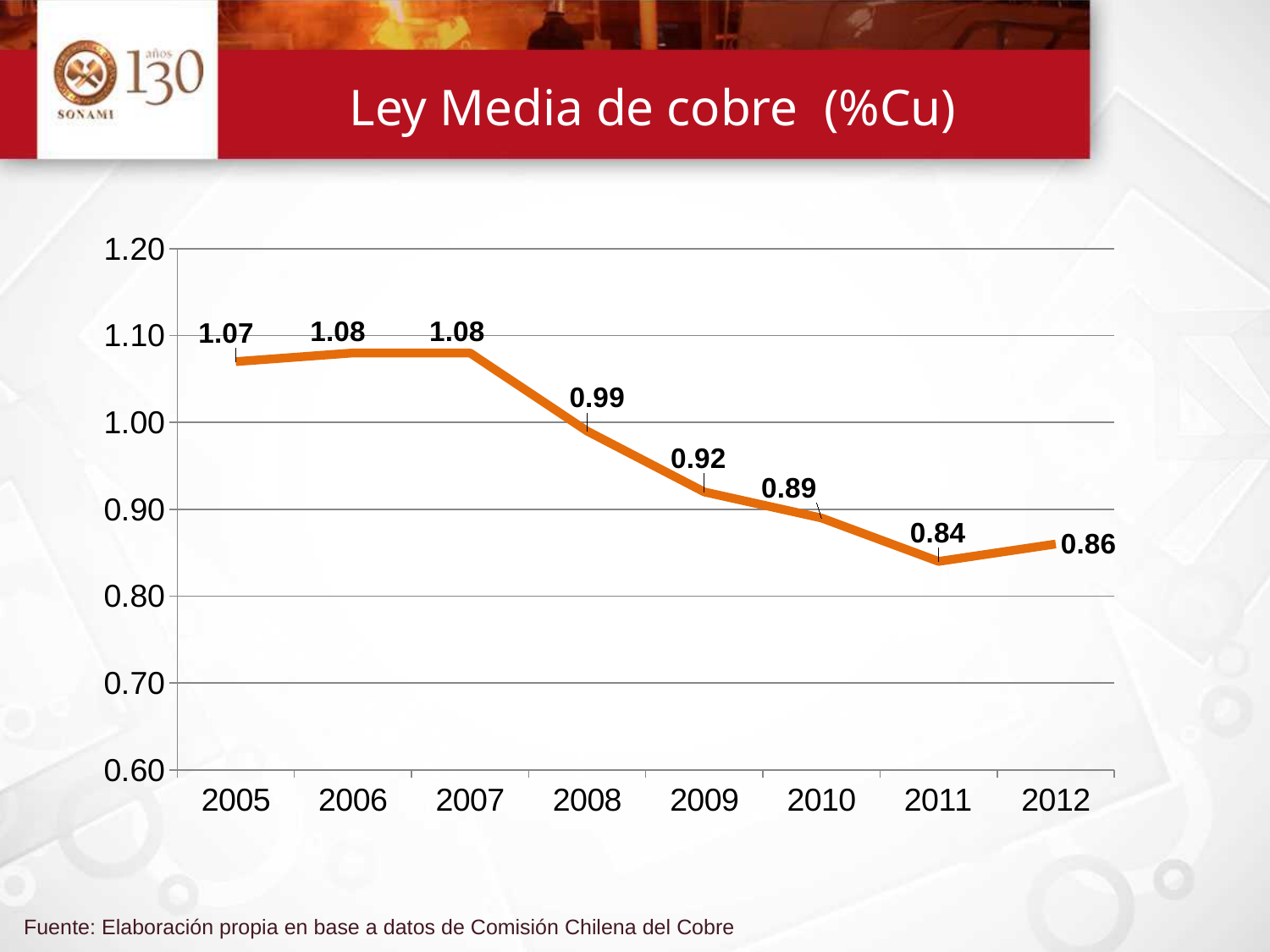
What kind of chart is shown? line chart What is the value for 2005? 1.07 What is the difference between the values for 2007 and 2011? 0.24 Which is larger, the value for 2008 or the value for 2010? 2008 What is the value for 2012? 0.86 What is the title of the chart? Ley Media de cobre (%Cu) Do the values generally rise or fall from 2007 to 2011? fall What colour is the line on the chart? orange What is the value for 2009? 0.92 How many years are plotted on the chart? 8 Is the value for 2010 greater or less than 1.00? less Which year has the lowest value? 2011